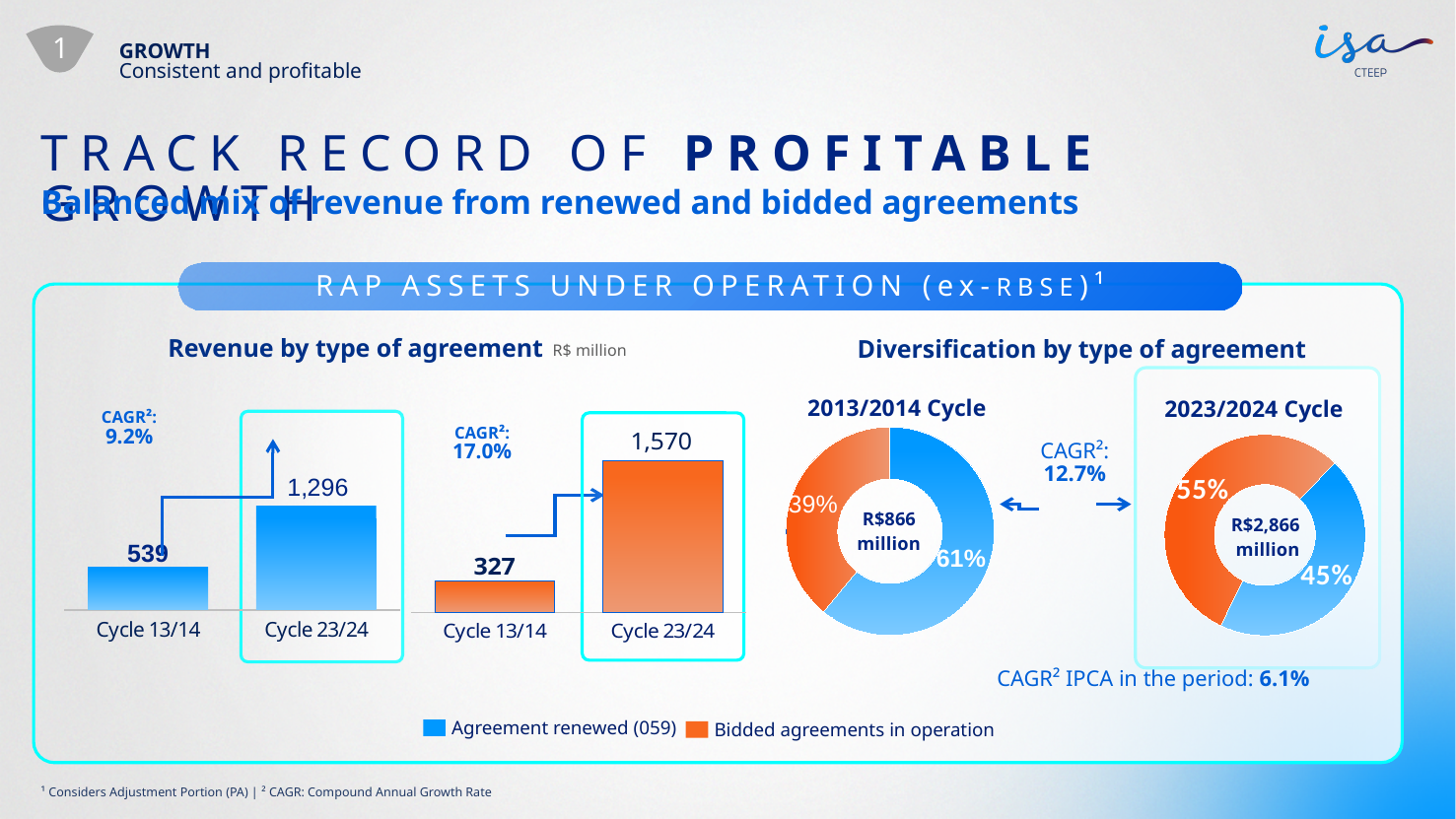
In the 'Revenue by type of agreement' chart, what is the value for Agreement renewed in Cycle 23/24? 1,296 How many series does the legend list? 2 What type of chart is used for 'Revenue by type of agreement'? Bar chart In the 'Revenue by type of agreement' chart, what is the value for Bidded agreements in operation in Cycle 13/14? 327 In the 'Revenue by type of agreement' chart, which bar has the lowest value? Bidded agreements in operation, Cycle 13/14 (327) In the '2023/2024 Cycle' donut chart, what share is Bidded agreements in operation? 55% What total value is shown in the centre of the '2023/2024 Cycle' donut chart? R$2,866 million In the 'Revenue by type of agreement' chart, what is the value for Bidded agreements in operation in Cycle 23/24? 1,570 In the 'Revenue by type of agreement' chart, which is larger in Cycle 23/24: Agreement renewed or Bidded agreements in operation? Bidded agreements in operation In the 'Revenue by type of agreement' chart, what is the difference between the Agreement renewed values for Cycle 23/24 and Cycle 13/14? 757 In the 'Revenue by type of agreement' chart, what is the value for Agreement renewed in Cycle 13/14? 539 In the '2013/2014 Cycle' donut chart, what share is Agreement renewed? 61%